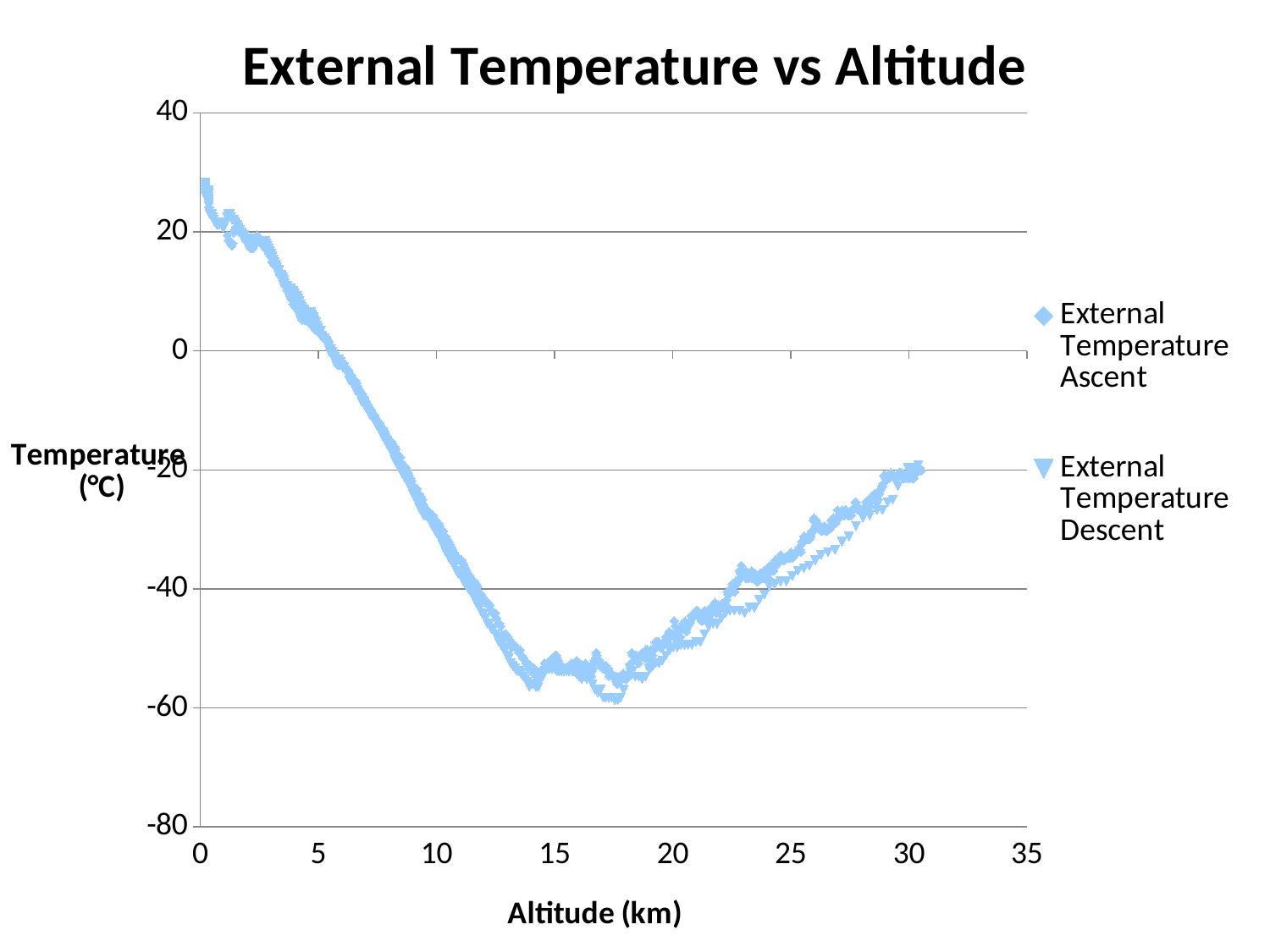
What is the label of the x axis? Altitude (km) Is the external temperature near an altitude of 0 km greater or less than 20? greater Is the external temperature at an altitude of 15 km greater or less than -40? less What is the title of the chart? External Temperature vs Altitude Is the external temperature at an altitude of 10 km greater or less than -20? less How many series does the legend list? 2 Does the external temperature rise or fall as altitude increases from 0 km to 15 km? fall What type of chart is shown on the slide? scatter chart Does the external temperature rise or fall as altitude increases from 20 km to 30 km? rise